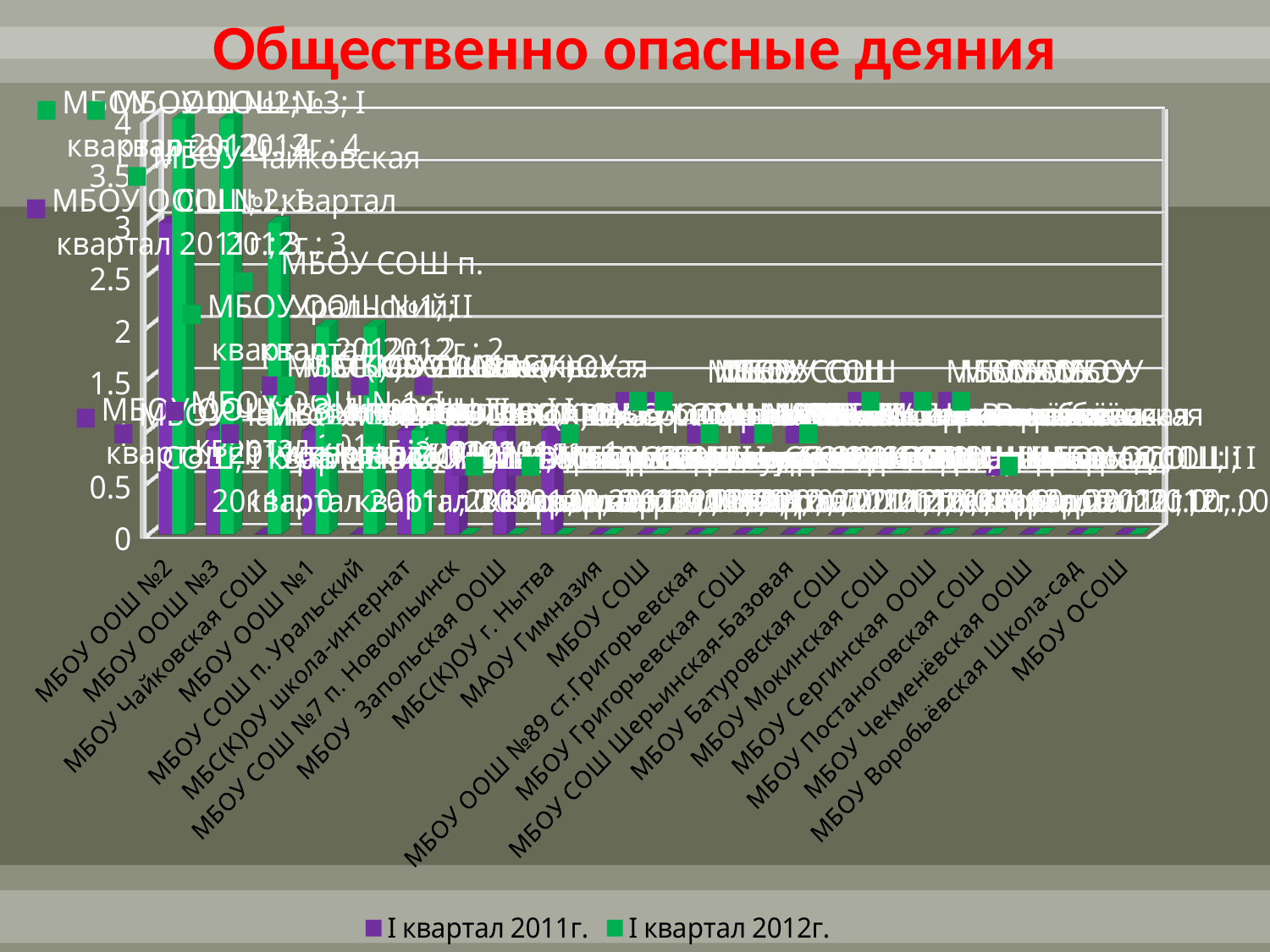
Is the I квартал 2012г. value for МБОУ ООШ №2 greater or less than 2? greater What kind of chart is shown on the slide? bar chart How many series does the legend list? 2 What are the two series named in the legend? I квартал 2011г. and I квартал 2012г. Which has the larger I квартал 2012г. value, МБОУ ООШ №2 or МБОУ ОСОШ? МБОУ ООШ №2 Is the I квартал 2011г. value for МБОУ ООШ №2 greater or less than 2? greater What is the value for МБОУ СОШ п. Уральский in the I квартал 2012г. series? 2 Do the values generally rise or fall moving from left to right along the x axis? fall What is the title of the chart? Общественно опасные деяния What is the value for МБОУ Чайковская СОШ in the I квартал 2012г. series? 3 How many school categories are shown along the x axis? 21